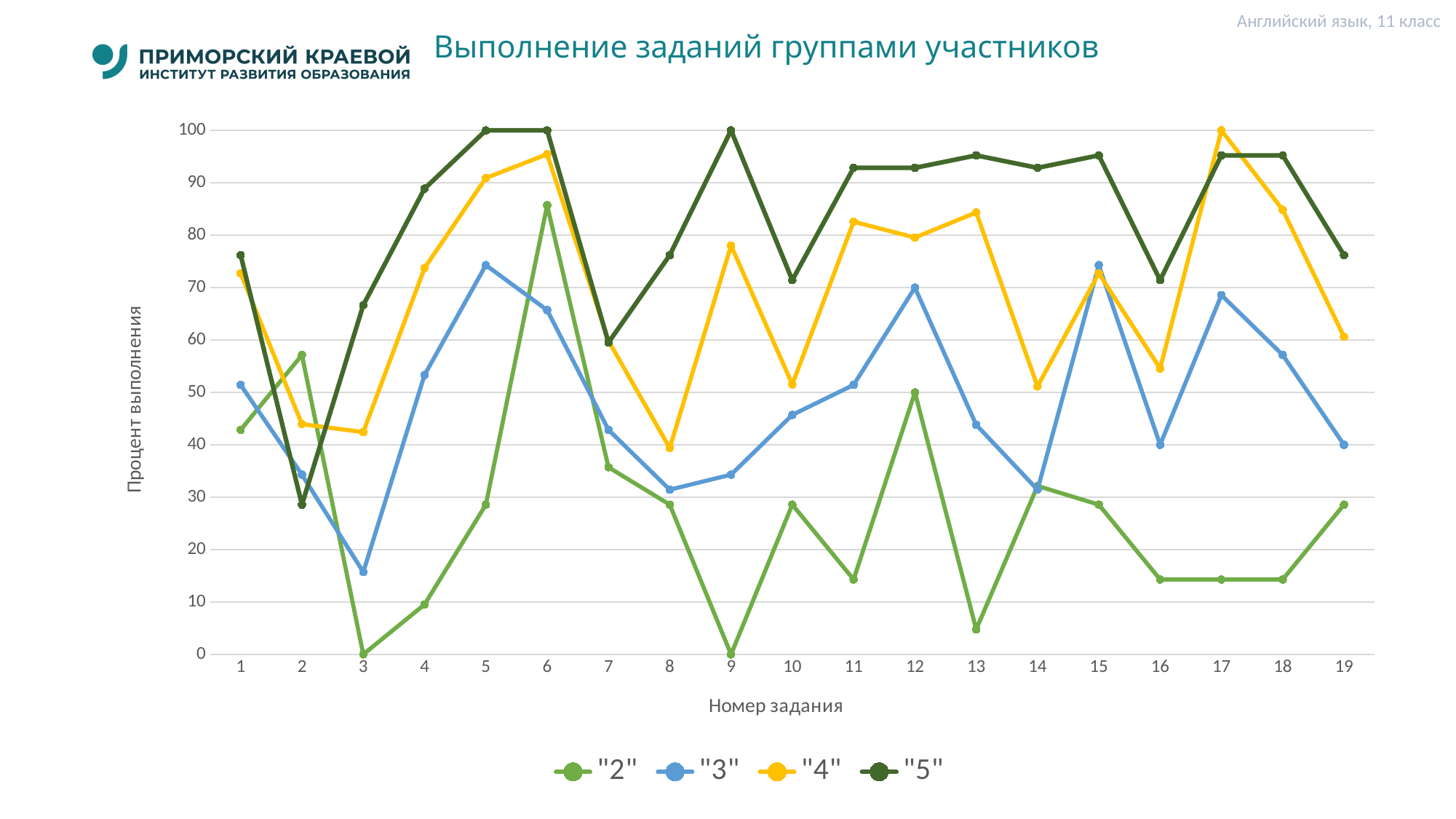
How many task numbers are shown along the x axis? 19 What is the value for series "5" at task 5? 100 What kind of chart is shown on the slide? line chart At task 13, which series has the larger value, "4" or "2"? "4" How many series does the legend list? 4 At which task number does series "2" reach its highest value? 6 At which task number does series "3" reach its lowest value? 3 Is the value for series "2" at task 6 greater or less than 80? greater Is the value for series "3" at task 3 greater or less than 20? less What is the value for series "4" at task 17? 100 Does series "4" rise or fall from task 17 to task 19? fall What is the value for series "2" at task 3? 0